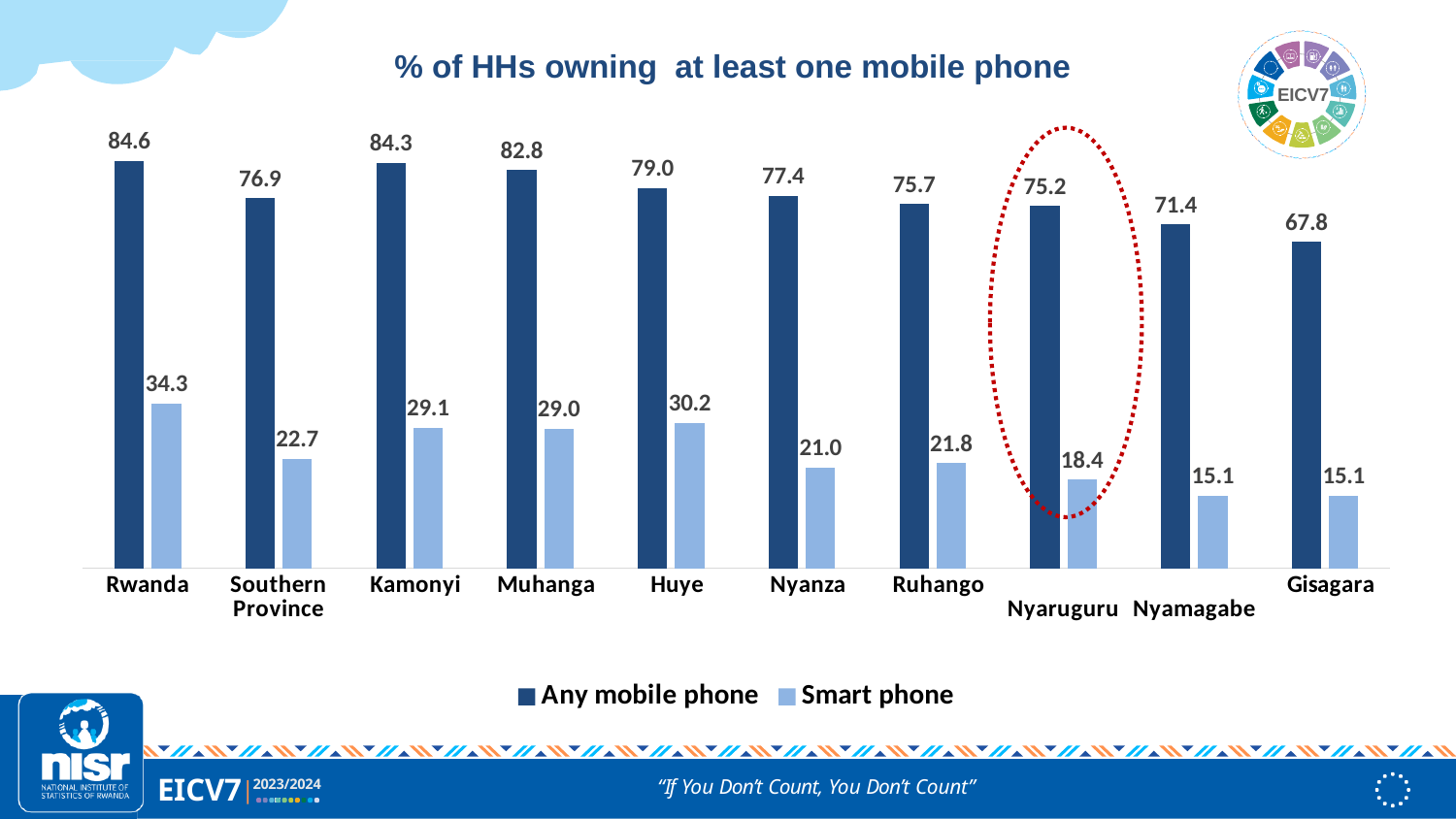
What is the Smart phone value for Nyaruguru? 18.4 Which category is highlighted with a red dotted circle? Nyaruguru Which has a higher Smart phone value, Nyanza or Ruhango? Ruhango Which category has the lowest Any mobile phone value? Gisagara What is the difference between the Any mobile phone and Smart phone values for Rwanda? 50.3 What is the Smart phone value for Huye? 30.2 How many series does the legend list? 2 What percentage of households in Kamonyi own at least one mobile phone (Any mobile phone)? 84.3 How many categories are shown on the x axis? 10 What is the Any mobile phone value for Southern Province? 76.9 What kind of chart is shown on the slide? Bar chart Which category has the highest Smart phone value? Rwanda